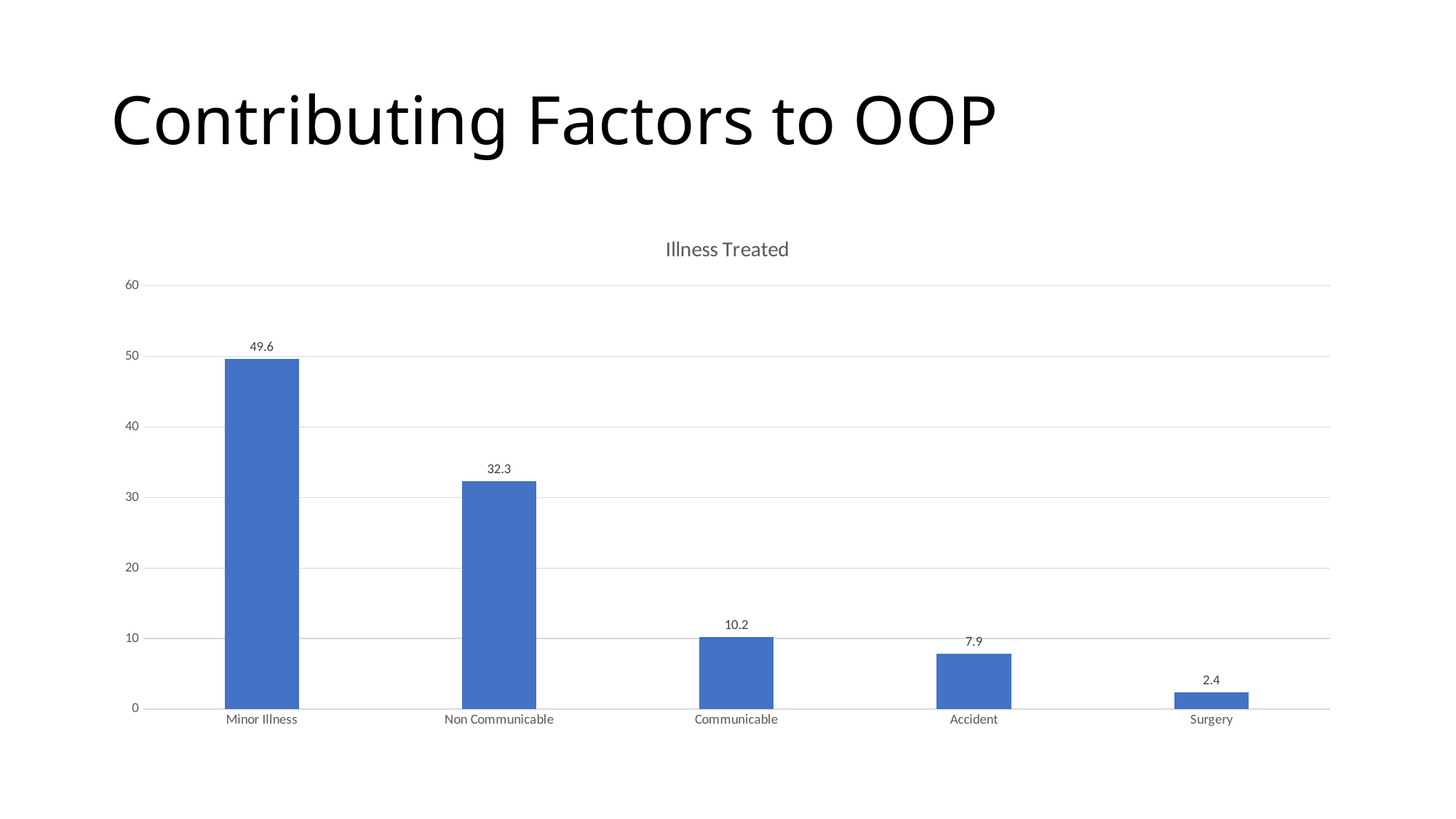
What is the value for Non Communicable? 32.3 What is the title of the chart? Illness Treated Is the value for Non Communicable greater or less than 30? greater What is the value for Accident? 7.9 What is the value for Surgery? 2.4 What is the value for Minor Illness? 49.6 Which is larger, the value for Communicable or the value for Accident? Communicable How many categories are shown on the x axis? 5 Which category has the lowest value? Surgery What is the difference between the values for Minor Illness and Non Communicable? 17.3 What kind of chart is shown on the slide? bar chart Which category has the highest value? Minor Illness